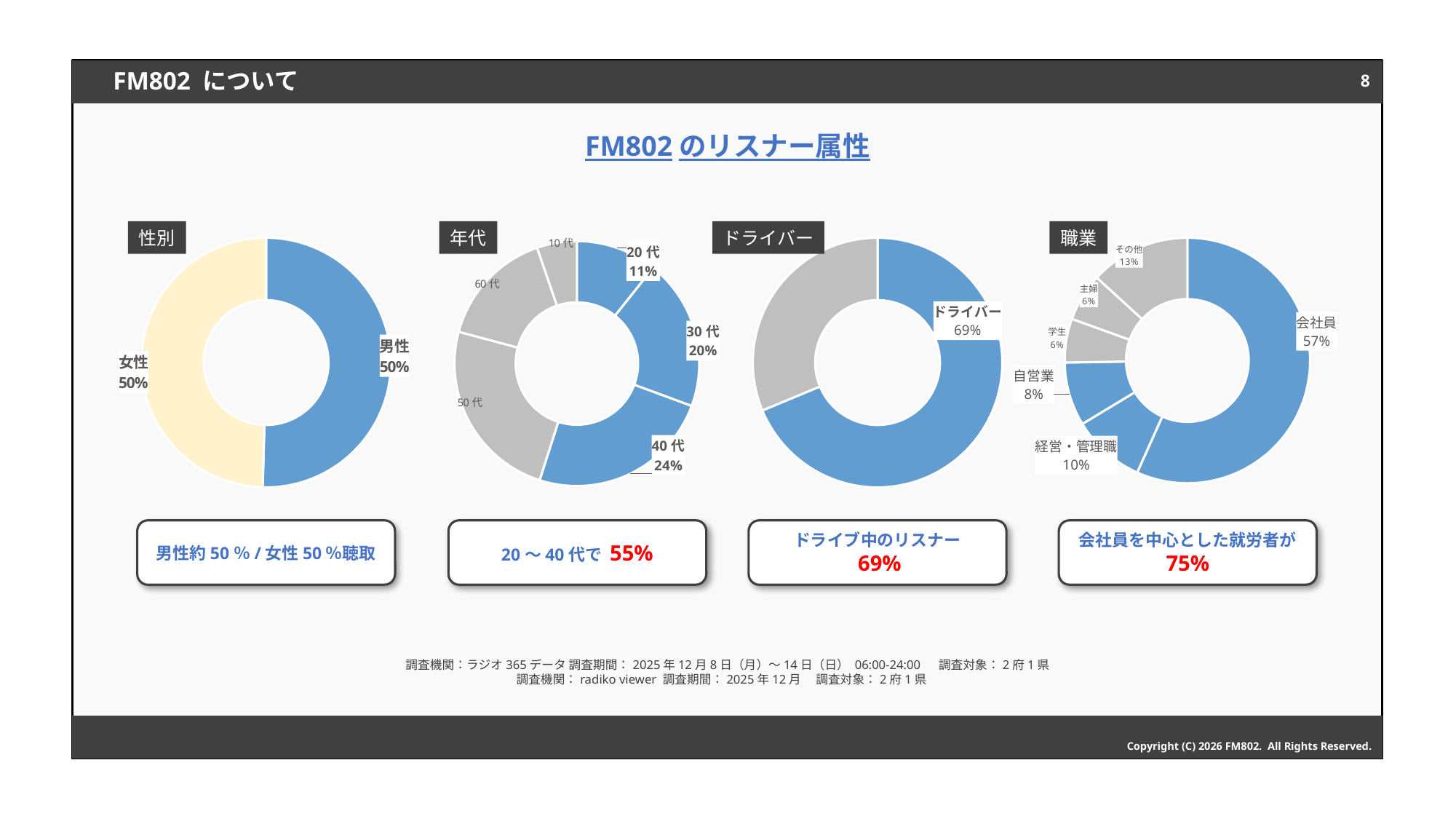
In the ドライバー chart, what is the value for ドライバー? 69% In the 職業 chart, which category has the largest share? 会社員 What kind of chart is the 性別 chart? Pie chart (donut) In the 職業 chart, which is larger, その他 or 自営業? その他 In the 年代 chart, how many age categories are shown? 6 In the 職業 chart, what is the difference between 会社員 and その他? 44% In the 職業 chart, what is the value for 経営・管理職? 10% In the 年代 chart, what is the value for 40 代? 24% In the 年代 chart, what is the difference between the 40 代 and 30 代 values? 4% How many donut charts are shown on the slide? 4 In the 年代 chart, what is the value for 20 代? 11% In the 性別 chart, what is the value for 男性? 50%